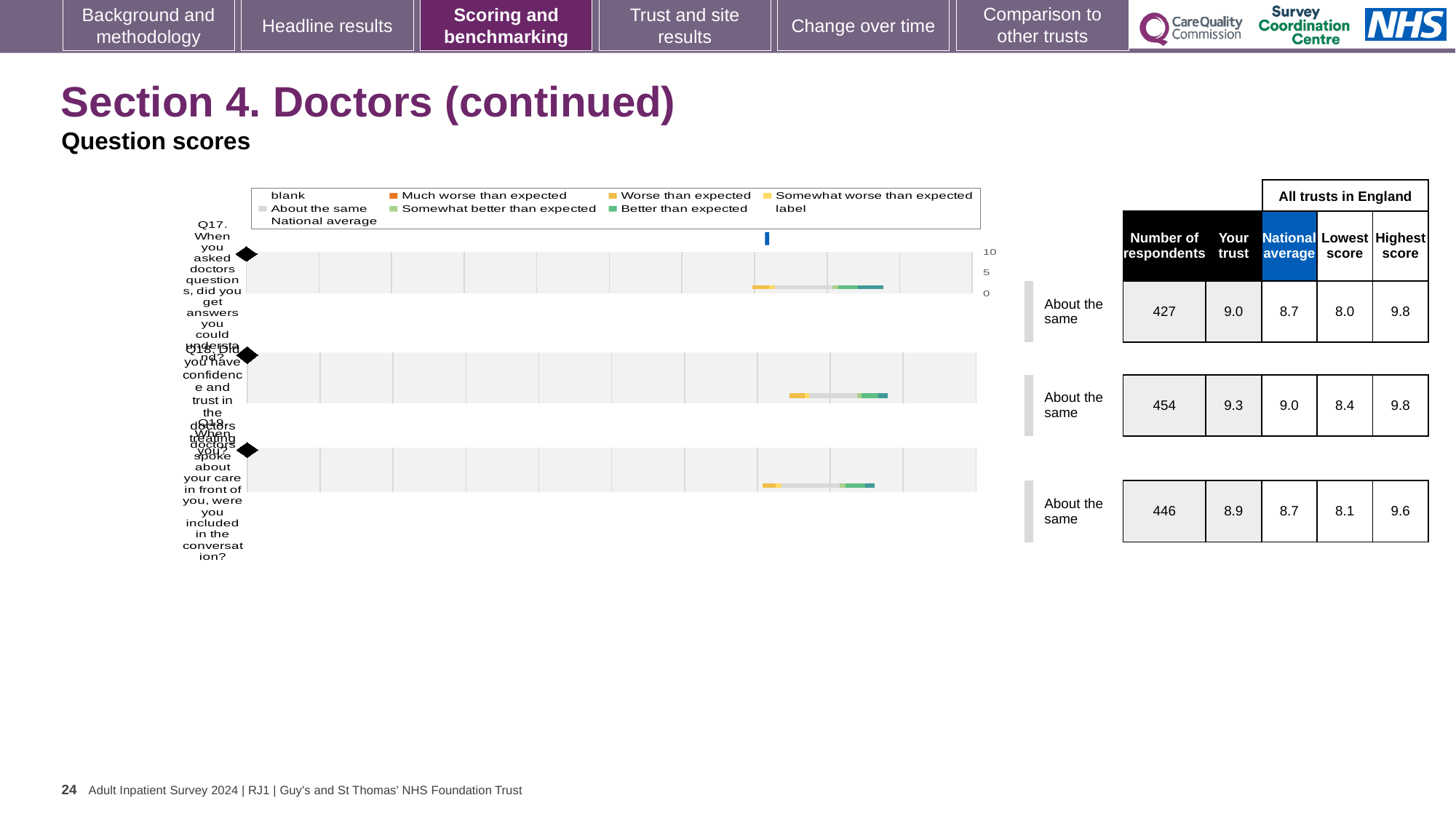
What is the 'Your trust' score for Q18 (confidence and trust in the doctors treating you)? 9.3 For Q17, which is larger: the 'Your trust' score or the national average? Your trust What is the lowest score among all trusts in England for Q18? 8.4 Which question has the lowest 'Your trust' score? Q19 What is the national average score for Q17 (getting answers you could understand from doctors)? 8.7 How many respondents answered Q19 (being included in conversations when doctors spoke about your care)? 446 What benchmark category is shown for all three questions on the slide? About the same Which question has the highest 'Your trust' score? Q18 What is the highest score among all trusts in England for Q19? 9.6 What kind of chart is shown on the slide? bar chart What is the difference between the 'Your trust' score and the national average for Q18? 0.3 How many questions (categories) are plotted in the chart? 3